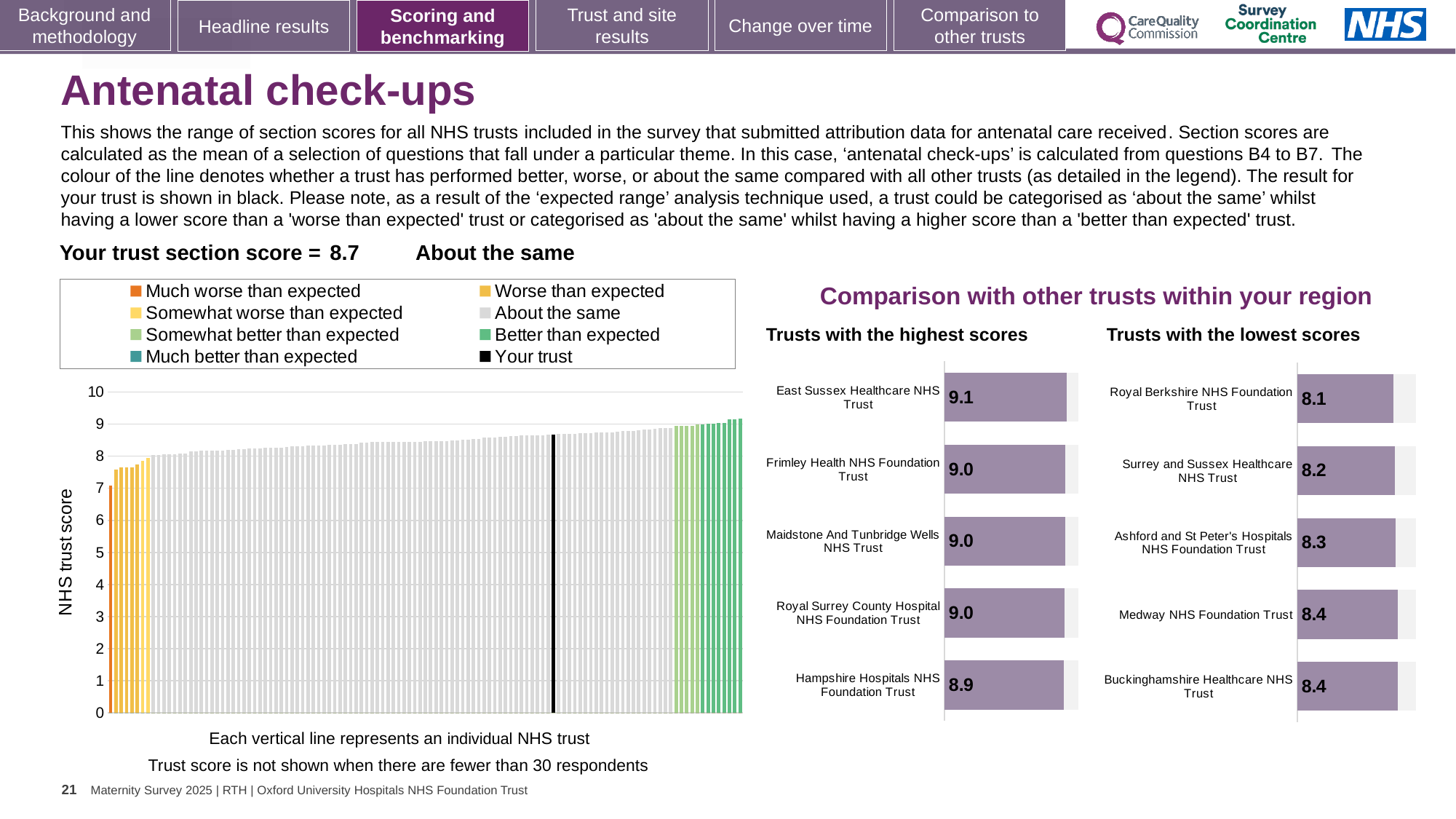
In the large chart on the left showing all NHS trusts, is the value for the black 'Your trust' bar greater or less than 8? greater In the 'Trusts with the highest scores' chart, what is the score for East Sussex Healthcare NHS Trust? 9.1 In the 'Trusts with the highest scores' chart, which trust has the lowest score? Hampshire Hospitals NHS Foundation Trust In the 'Trusts with the lowest scores' chart, which has the larger score: Surrey and Sussex Healthcare NHS Trust or Medway NHS Foundation Trust? Medway NHS Foundation Trust In the 'Trusts with the lowest scores' chart, what is the difference between the scores of Ashford and St Peter's Hospitals NHS Foundation Trust and Royal Berkshire NHS Foundation Trust? 0.2 In the large chart on the left showing all NHS trusts, how many entries does the legend list? 8 In the 'Trusts with the highest scores' chart, what is the difference between the scores of East Sussex Healthcare NHS Trust and Hampshire Hospitals NHS Foundation Trust? 0.2 In the large chart on the left showing all NHS trusts, what kind of chart is it? Bar chart In the 'Trusts with the highest scores' chart, how many trusts are shown? 5 In the large chart on the left showing all NHS trusts, do the scores rise or fall from left to right? Rise In the 'Trusts with the lowest scores' chart, what is the score for Royal Berkshire NHS Foundation Trust? 8.1 In the 'Trusts with the lowest scores' chart, which trust has the lowest score? Royal Berkshire NHS Foundation Trust